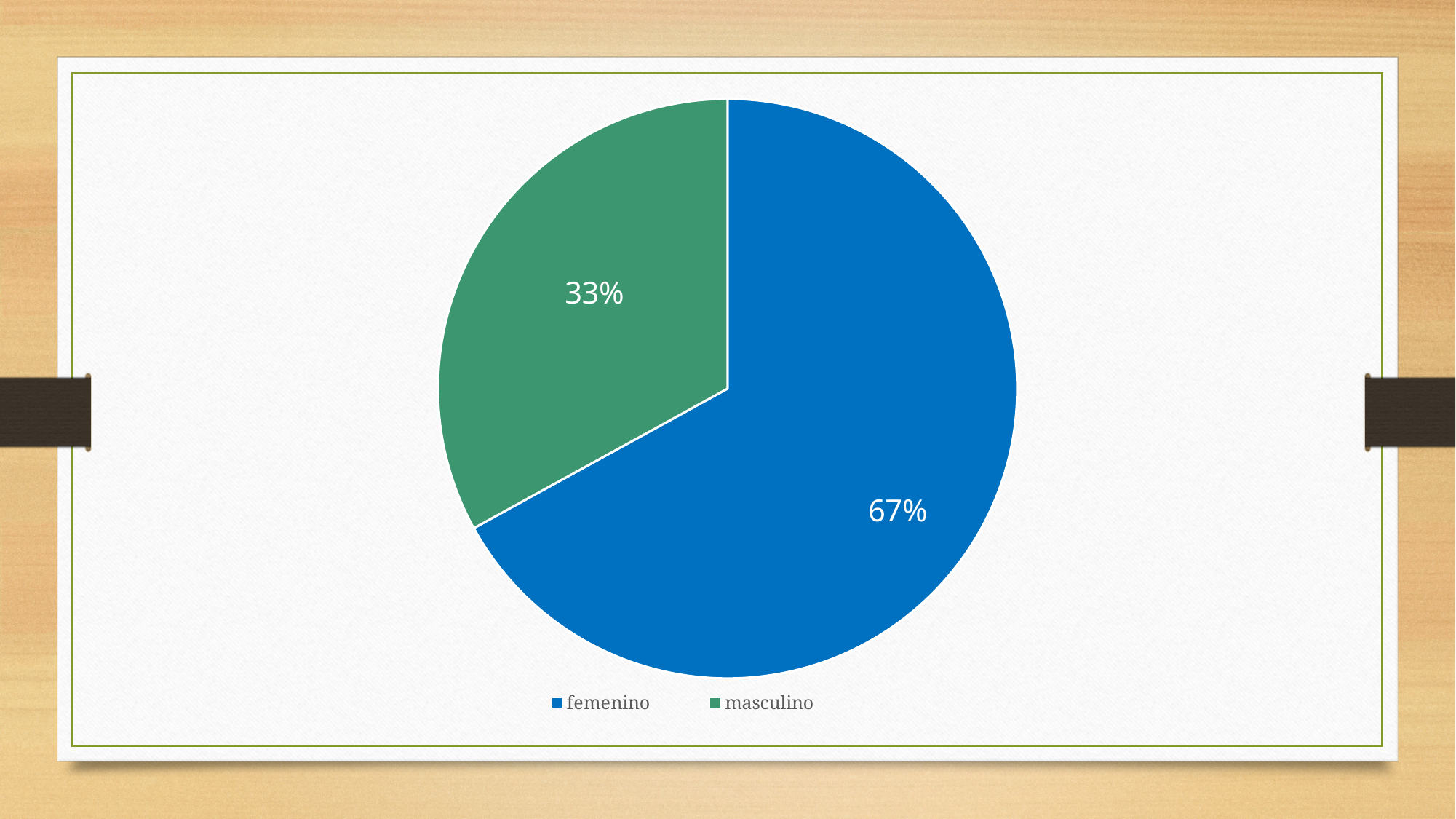
Which category has the largest slice of the pie? femenino How many entries does the legend list? 2 What share of the pie does femenino represent? 67% How many categories does the pie chart show? 2 Which is larger, the femenino slice or the masculino slice? femenino What share of the pie does masculino represent? 33% What kind of chart is shown on the slide? pie chart What is the difference in percentage points between the femenino and masculino slices? 34 What colour is the masculino slice? green Which category has the smallest slice of the pie? masculino What colour is the femenino slice? blue